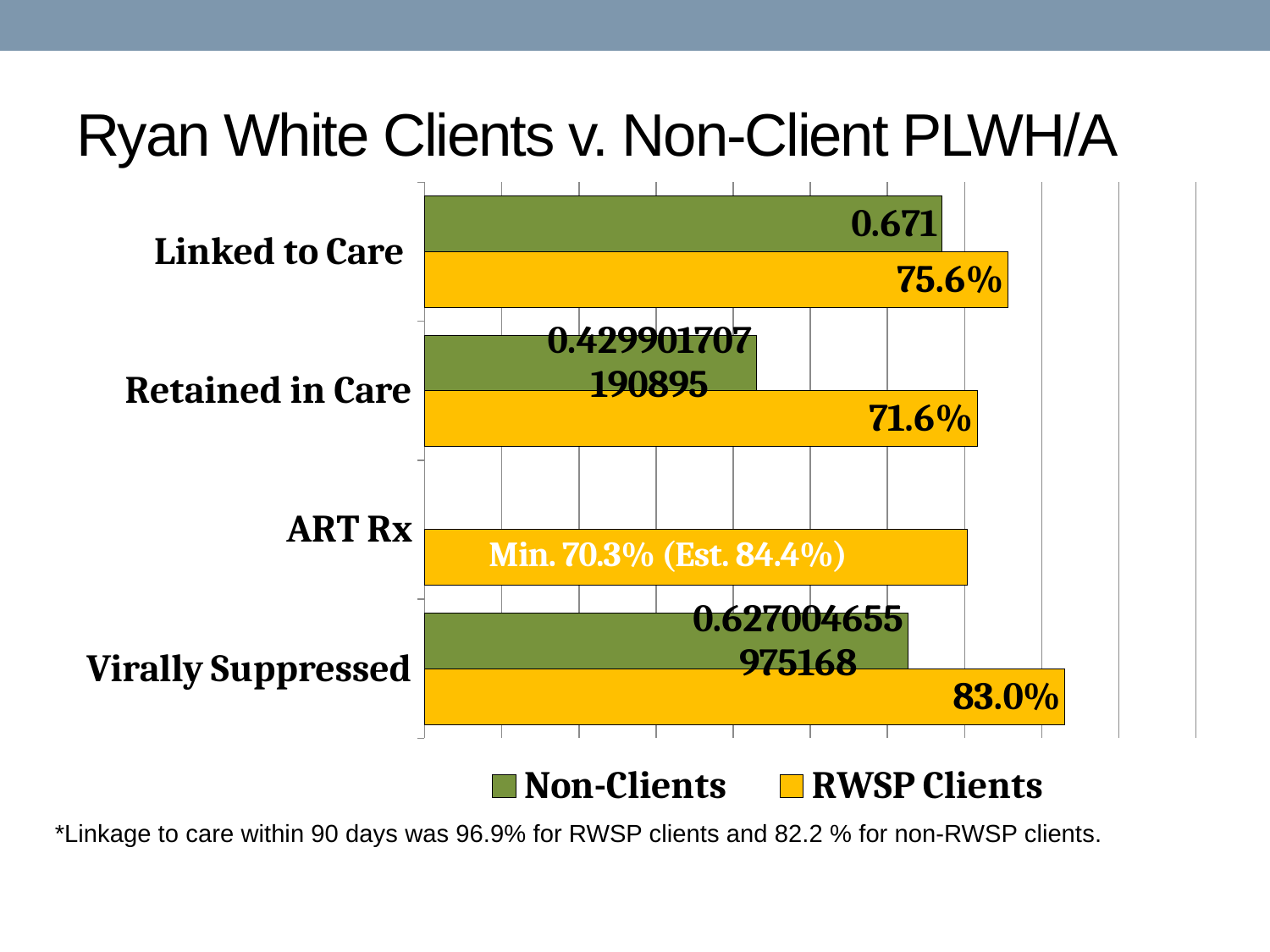
Which category has the lowest value for Non-Clients among those with a bar shown? Retained in Care What kind of chart is shown on the slide? Bar chart What is the value for RWSP Clients in the Retained in Care category? 71.6% What is the value for Non-Clients in the Linked to Care category? 0.671 Which series is shown in yellow in the legend? RWSP Clients What is the value for RWSP Clients in the Virally Suppressed category? 83.0% In the Retained in Care category, which series has the larger value, Non-Clients or RWSP Clients? RWSP Clients What label is shown on the RWSP Clients bar for ART Rx? Min. 70.3% (Est. 84.4%) What is the difference between the RWSP Clients values for Virally Suppressed and Linked to Care? 7.4% How many categories are shown on the chart? 4 Which category has the highest value for RWSP Clients? Virally Suppressed How many series does the legend list? 2